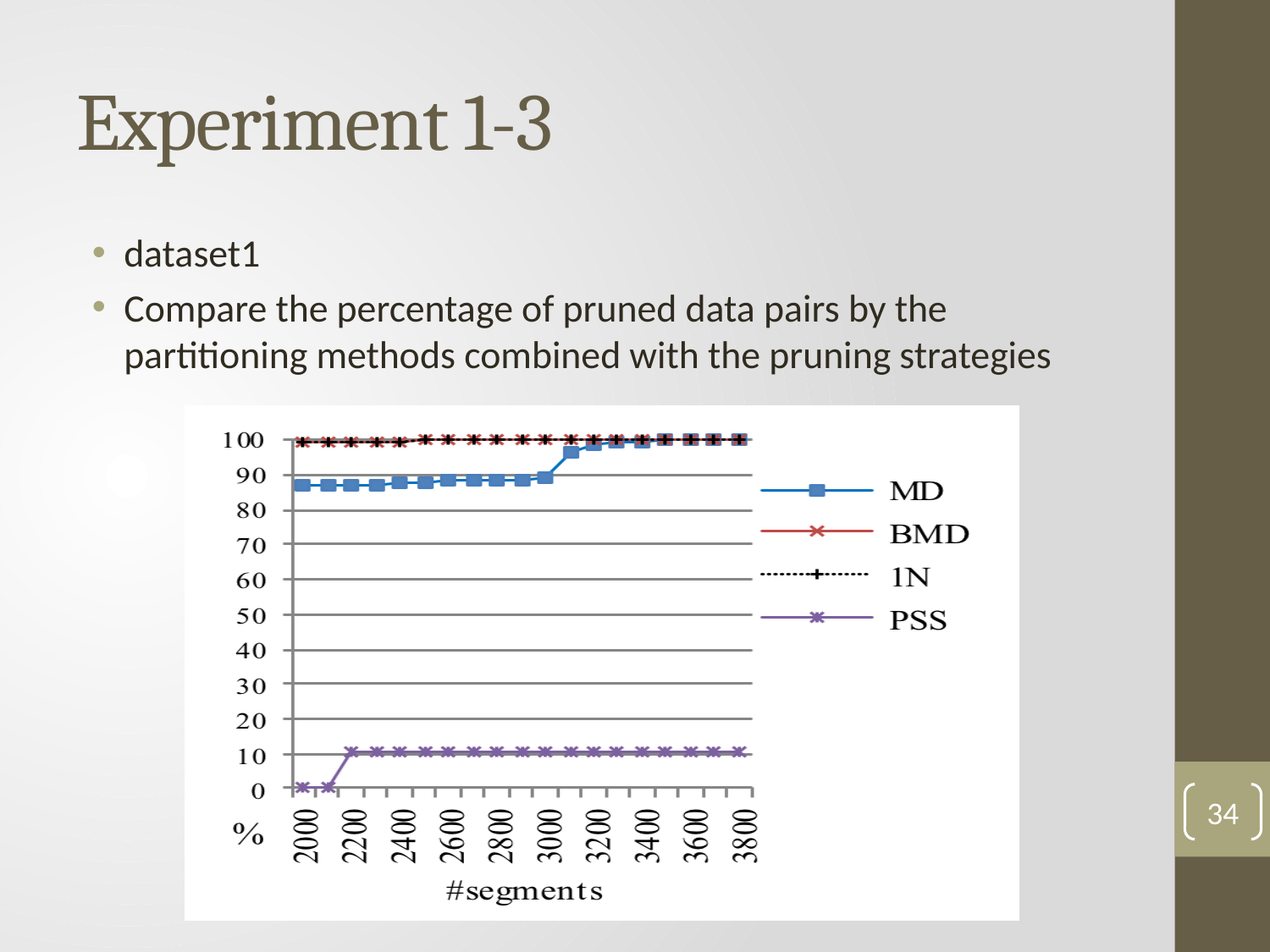
What are the series names listed in the chart legend? MD, BMD, 1N, PSS Is the value for MD at 2000 segments greater or less than 90? less What is the x-axis title of the chart? #segments At 2000 segments, which is larger, BMD or MD? BMD At 2600 segments, which is larger, MD or PSS? MD Is the value for MD at 2000 segments greater or less than 80? greater Does the MD series rise or fall as #segments increases from 2000 to 3800? rise How many series does the chart legend list? 4 What kind of chart is shown on the slide? line chart What is the value for PSS at 2000 segments? 0 Is the value for PSS at 3000 segments greater or less than 20? less Which series has the lowest value at 3000 segments? PSS